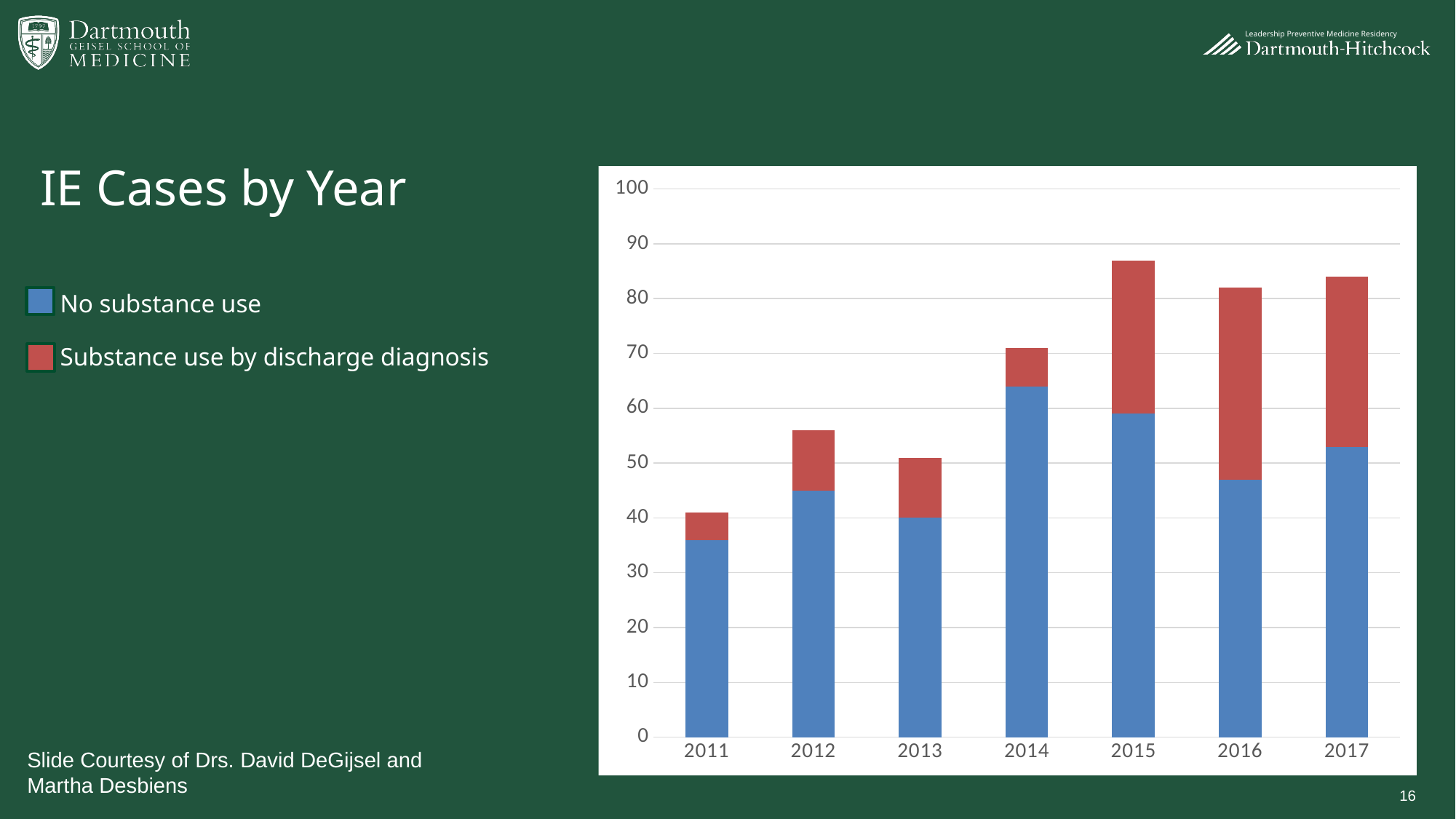
Is the total bar height for 2011 greater or less than 50? less What kind of chart is shown on the slide? Stacked bar chart What is the title of the chart on the slide? IE Cases by Year How many years are shown on the x axis of the chart? 7 Is the 'No substance use' value for 2013 greater or less than 50? less Is the 'No substance use' value for 2014 greater or less than 60? greater Which colour represents 'Substance use by discharge diagnosis' in the chart? Red Which year has the lowest total number of IE cases? 2011 How many series does the legend list? 2 Which year has the larger total bar, 2013 or 2014? 2014 Which year has the tallest blue 'No substance use' segment? 2014